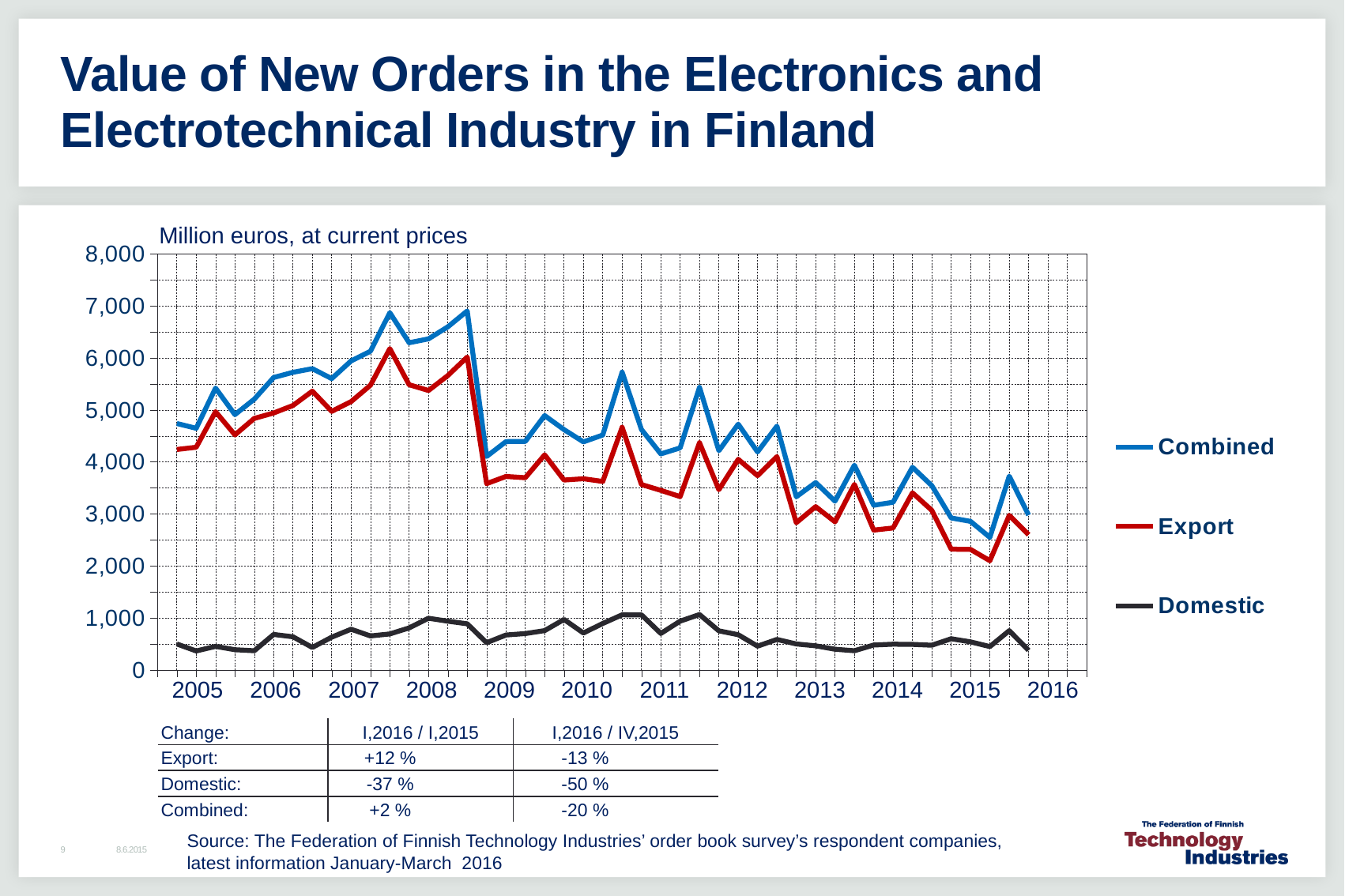
Is the Combined value at its 2008 peak greater or less than 6,000? greater What unit is stated above the chart? Million euros, at current prices Is the Export value at the start of 2009 greater or less than 4,000? less Is the Domestic value at the start of 2005 greater or less than 1,000? less Does the Combined series rise or fall between 2005 and the 2008 peak? rise Which series is larger in 2012, Export or Domestic? Export How many series does the legend list? 3 What kind of chart is shown on the slide? line chart What are the three series named in the legend? Combined, Export, Domestic Does the Combined series overall rise or fall from 2008 to 2016? fall How many years are labelled on the x axis? 12